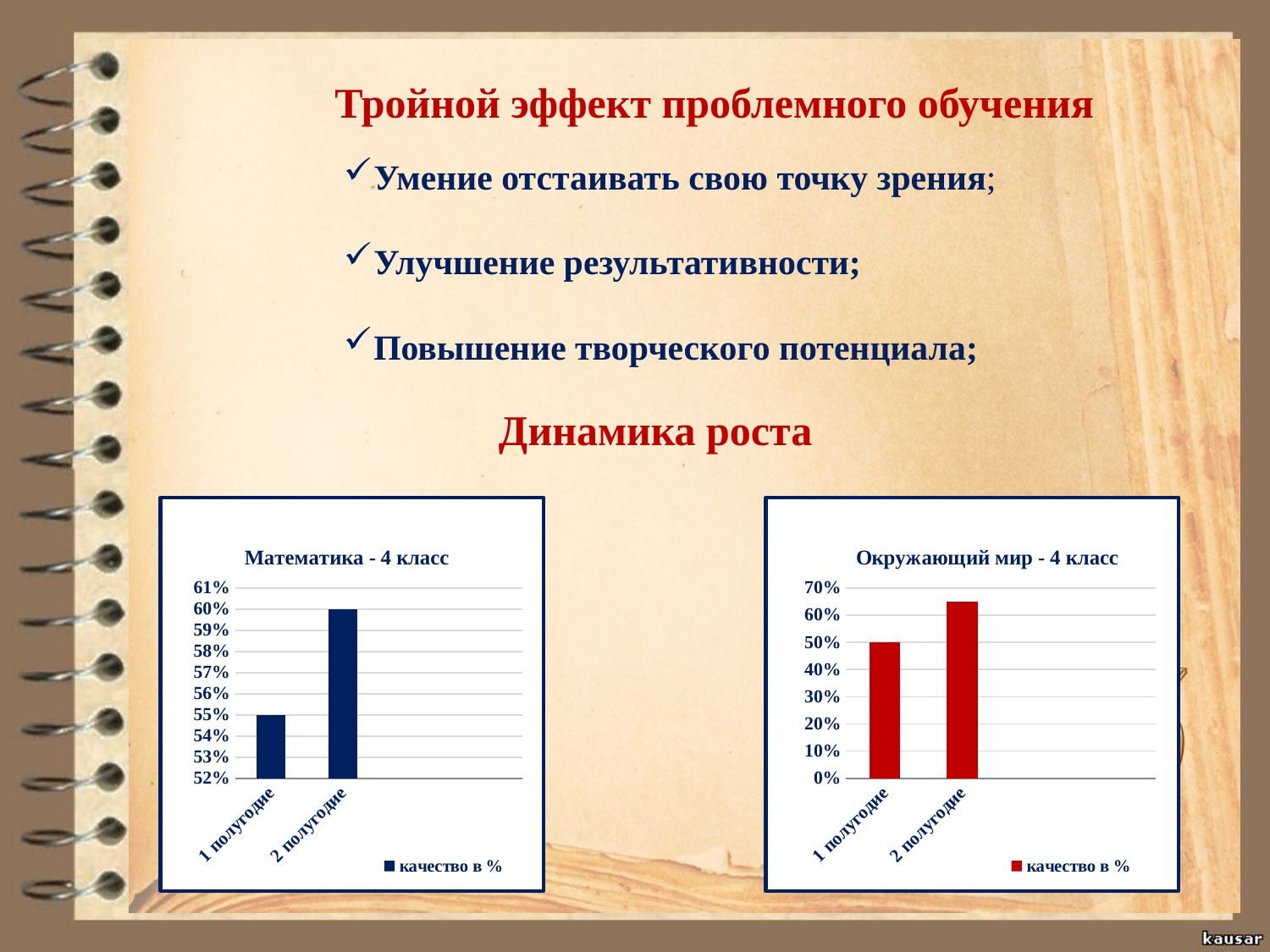
In the chart titled "Математика - 4 класс", what is the value for 1 полугодие? 55% In the chart titled "Математика - 4 класс", what is the difference between the values for 2 полугодие and 1 полугодие? 5% In the chart titled "Окружающий мир - 4 класс", which is larger: the value for 1 полугодие or 2 полугодие? 2 полугодие What kind of chart is the chart titled "Окружающий мир - 4 класс"? bar chart In the chart titled "Окружающий мир - 4 класс", is the value for 2 полугодие greater or less than 60%? greater In the chart titled "Математика - 4 класс", which category has the highest value? 2 полугодие In the chart titled "Окружающий мир - 4 класс", what is the value for 1 полугодие? 50% How many categories are shown on the x axis of the chart titled "Математика - 4 класс"? 2 In the chart titled "Окружающий мир - 4 класс", which category has the lowest value? 1 полугодие In the chart titled "Математика - 4 класс", what is the value for 2 полугодие? 60% In the chart titled "Окружающий мир - 4 класс", do the values rise or fall from 1 полугодие to 2 полугодие? rise What series name does the legend of the chart titled "Математика - 4 класс" show? качество в %